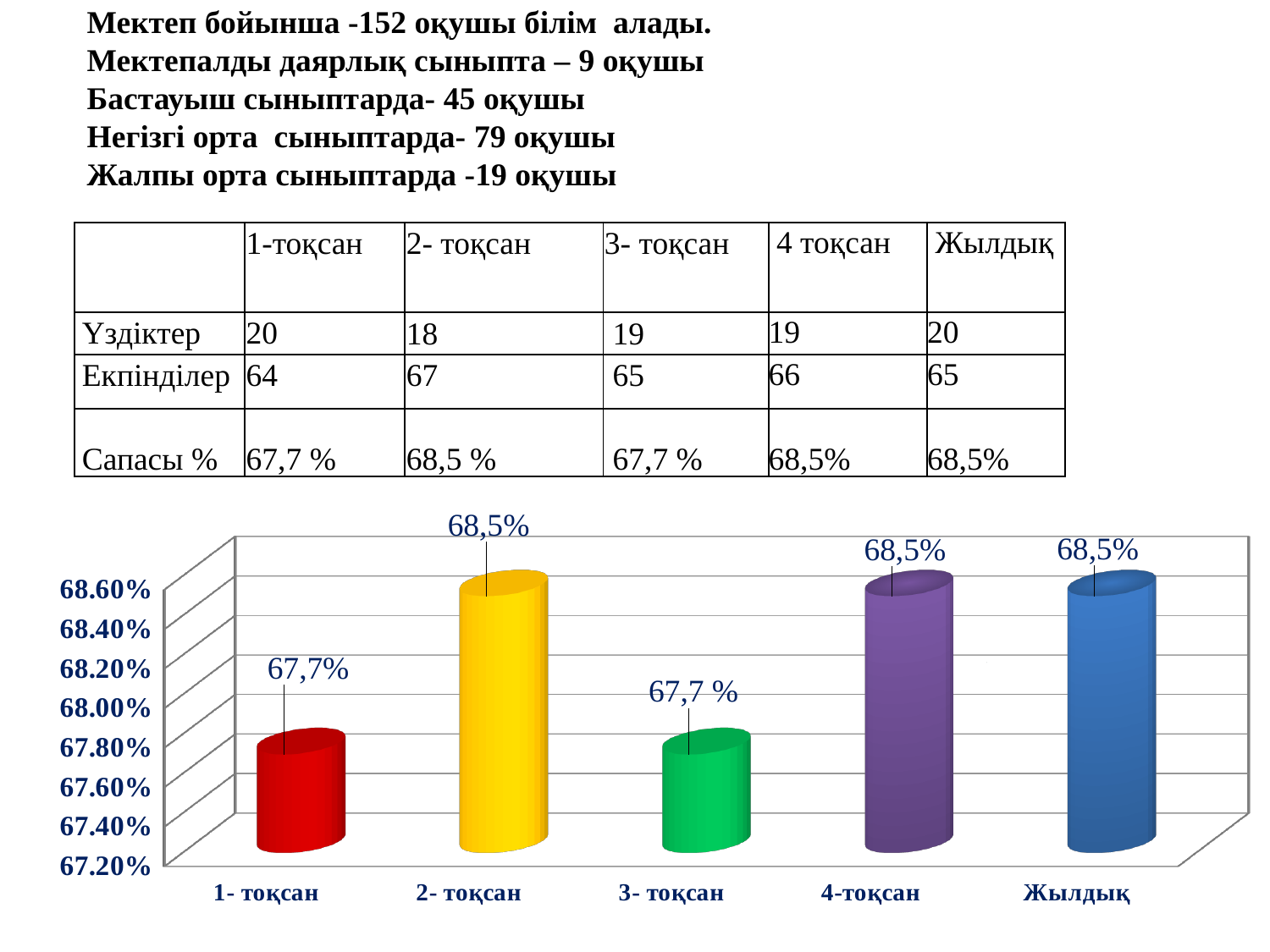
What is the value shown for 3- тоқсан in the chart? 67,7 % Is the value for 4-тоқсан greater or less than 68.00%? greater Is the value for 1- тоқсан greater or less than 68.00%? less Which is larger, the value for 1- тоқсан or the value for 2- тоқсан? 2- тоқсан Which is larger, the value for 3- тоқсан or the value for 4-тоқсан? 4-тоқсан What kind of chart is shown on the slide? Bar chart What is the value shown for 2- тоқсан in the chart? 68,5% What is the value shown for 1- тоқсан in the chart? 67,7% What is the difference between the value for 2- тоқсан and the value for 1- тоқсан? 0,8% What is the value shown for Жылдық in the chart? 68,5% What colour is the bar for 1- тоқсан? Red How many categories are plotted along the x axis of the chart? 5